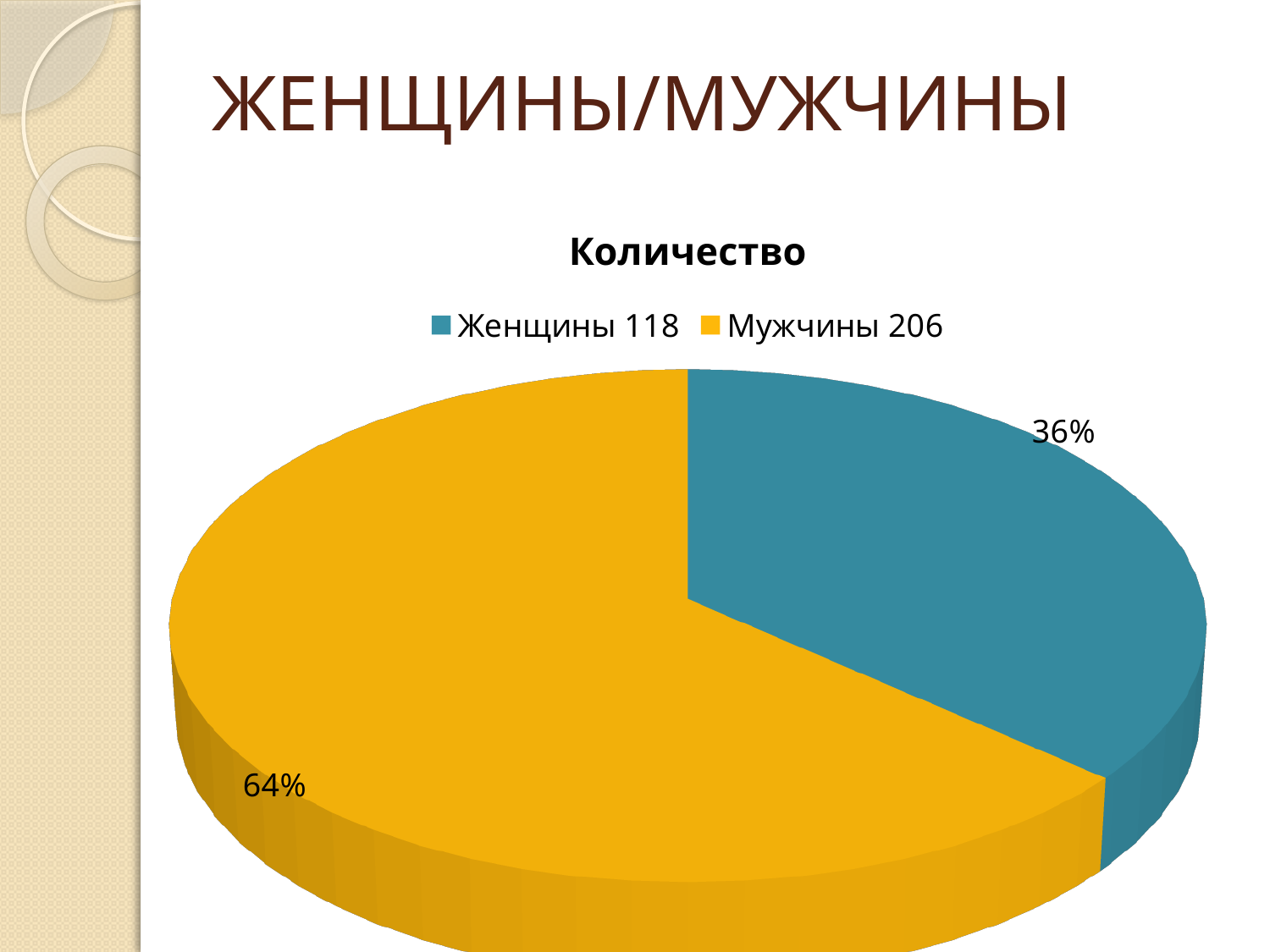
What share of the pie does the Женщины 118 slice represent? 36% What colour is the Женщины slice in the pie chart? blue What is the difference in percentage points between the Мужчины slice and the Женщины slice? 28% What is the title of the chart? Количество How many entries does the legend list? 2 Which slice is the largest in the pie chart? Мужчины 206 What kind of chart is shown on the slide? pie chart What share of the pie does the Мужчины 206 slice represent? 64% Is the share for Мужчины greater or less than 50%? greater Which is larger, the Женщины slice or the Мужчины slice? Мужчины Which slice is the smallest in the pie chart? Женщины 118 How many slices does the pie chart have? 2